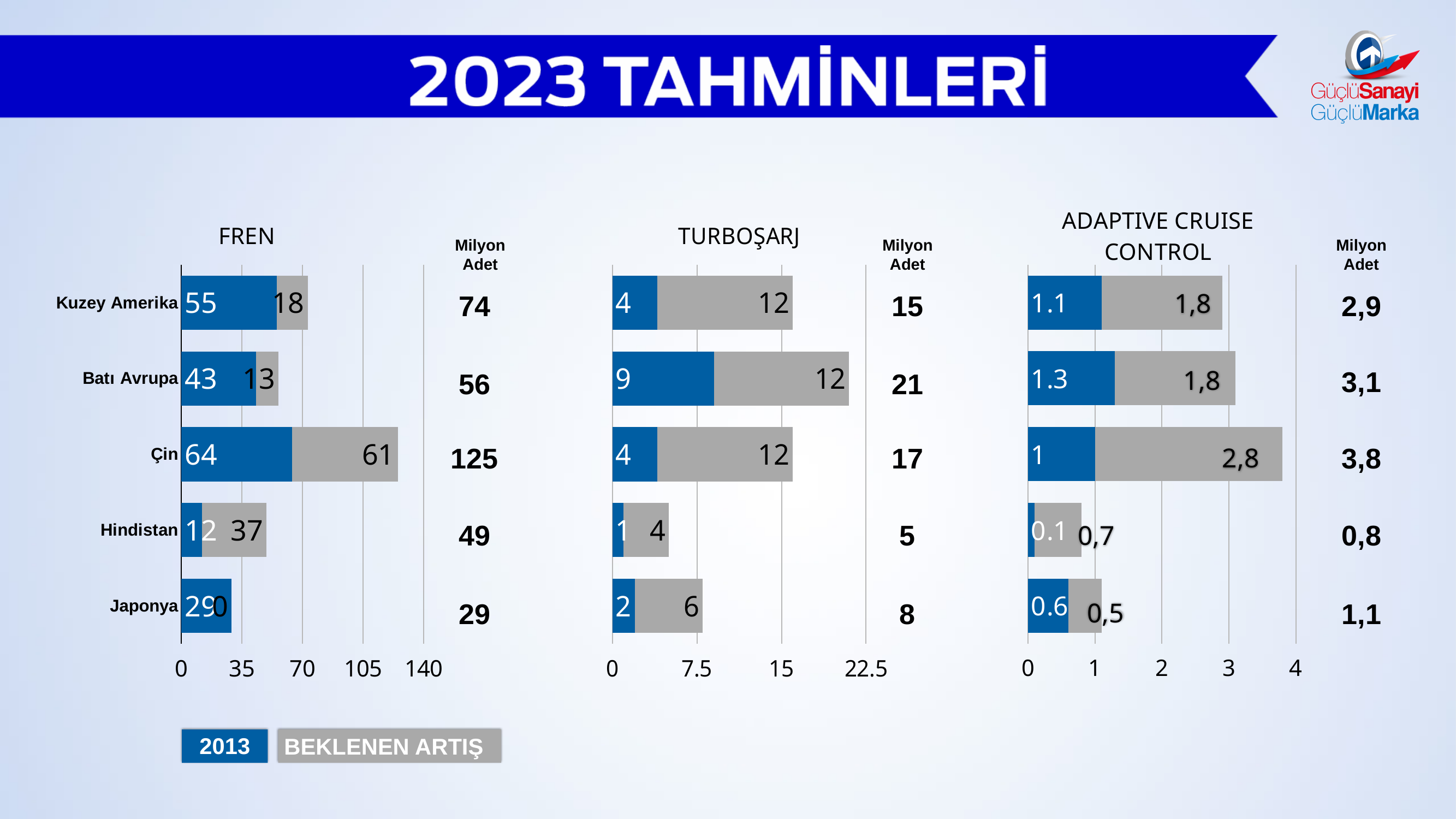
What kind of chart is the FREN chart? bar chart In the TURBOŞARJ chart, what is the 2013 value for Batı Avrupa? 9 In the TURBOŞARJ chart, which category has the highest 2013 value? Batı Avrupa In the FREN chart, which category has the highest 2013 value? Çin In the ADAPTIVE CRUISE CONTROL chart, what is the BEKLENEN ARTIŞ value for Çin? 2,8 In the ADAPTIVE CRUISE CONTROL chart, which has the larger 2013 value, Kuzey Amerika or Batı Avrupa? Batı Avrupa In the FREN chart, what is the 2013 value for Çin? 64 In the FREN chart, what is the BEKLENEN ARTIŞ value for Hindistan? 37 In the FREN chart, which category has the lowest BEKLENEN ARTIŞ value? Japonya In the FREN chart, what is the total of the stacked bar for Çin? 125 How many series does the legend list? 2 In the FREN chart, what is the difference between the 2013 values for Kuzey Amerika and Batı Avrupa? 12